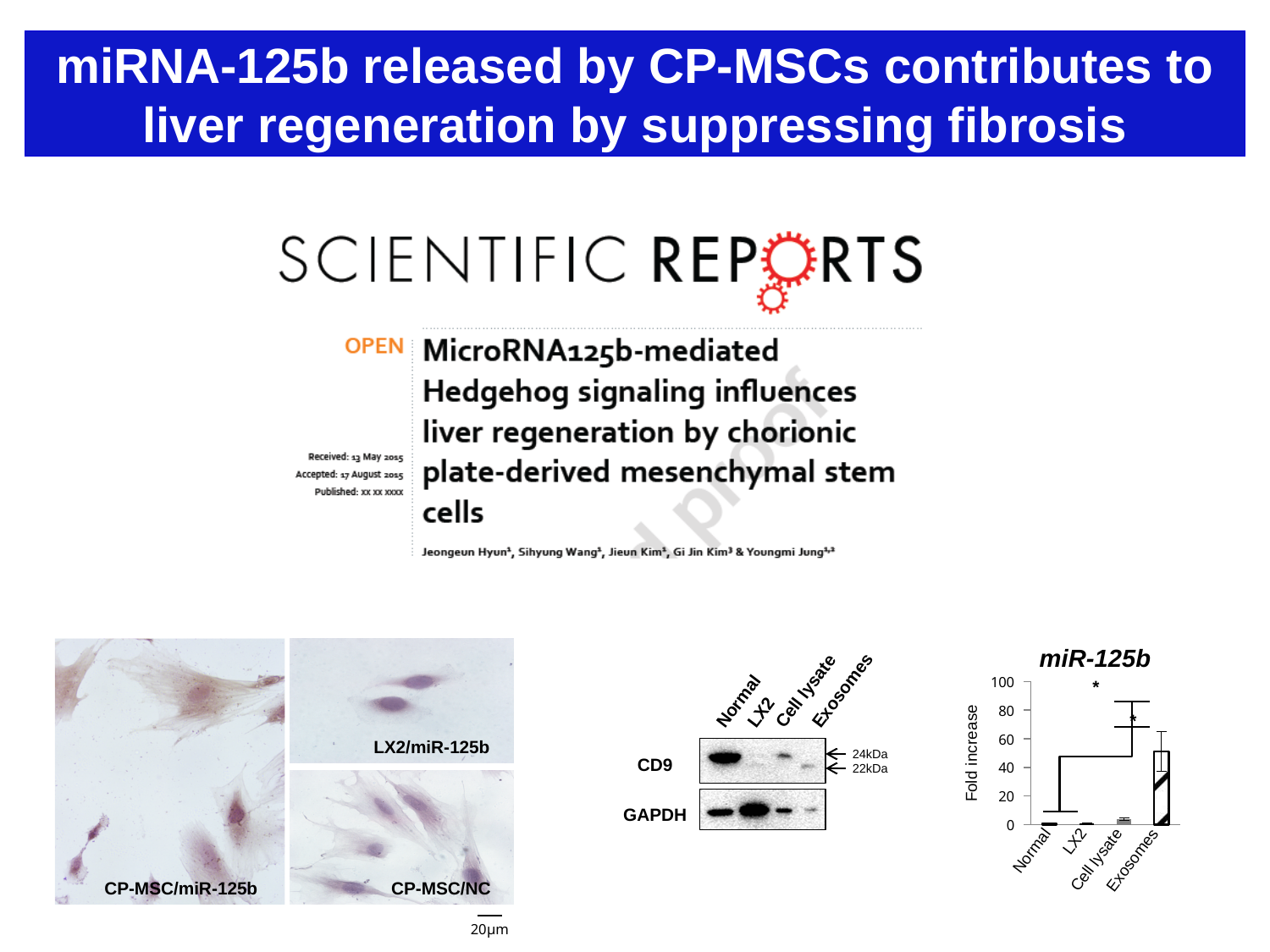
In the miR-125b chart, is the value for Exosomes greater or less than 40? greater What kind of chart is the miR-125b chart? bar chart How many categories are shown on the x axis of the miR-125b chart? 4 In the miR-125b chart, is the value for Cell lysate greater or less than 20? less In the miR-125b chart, which is larger, the value for Exosomes or the value for LX2? Exosomes What is the label of the y axis in the miR-125b chart? Fold increase Which category has the highest value in the miR-125b chart? Exosomes In the miR-125b chart, is the value for Exosomes greater or less than 80? less In the miR-125b chart, which is larger, the value for Exosomes or the value for Cell lysate? Exosomes What is the maximum value shown on the y axis of the miR-125b chart? 100 What is the title of the chart on the slide? miR-125b